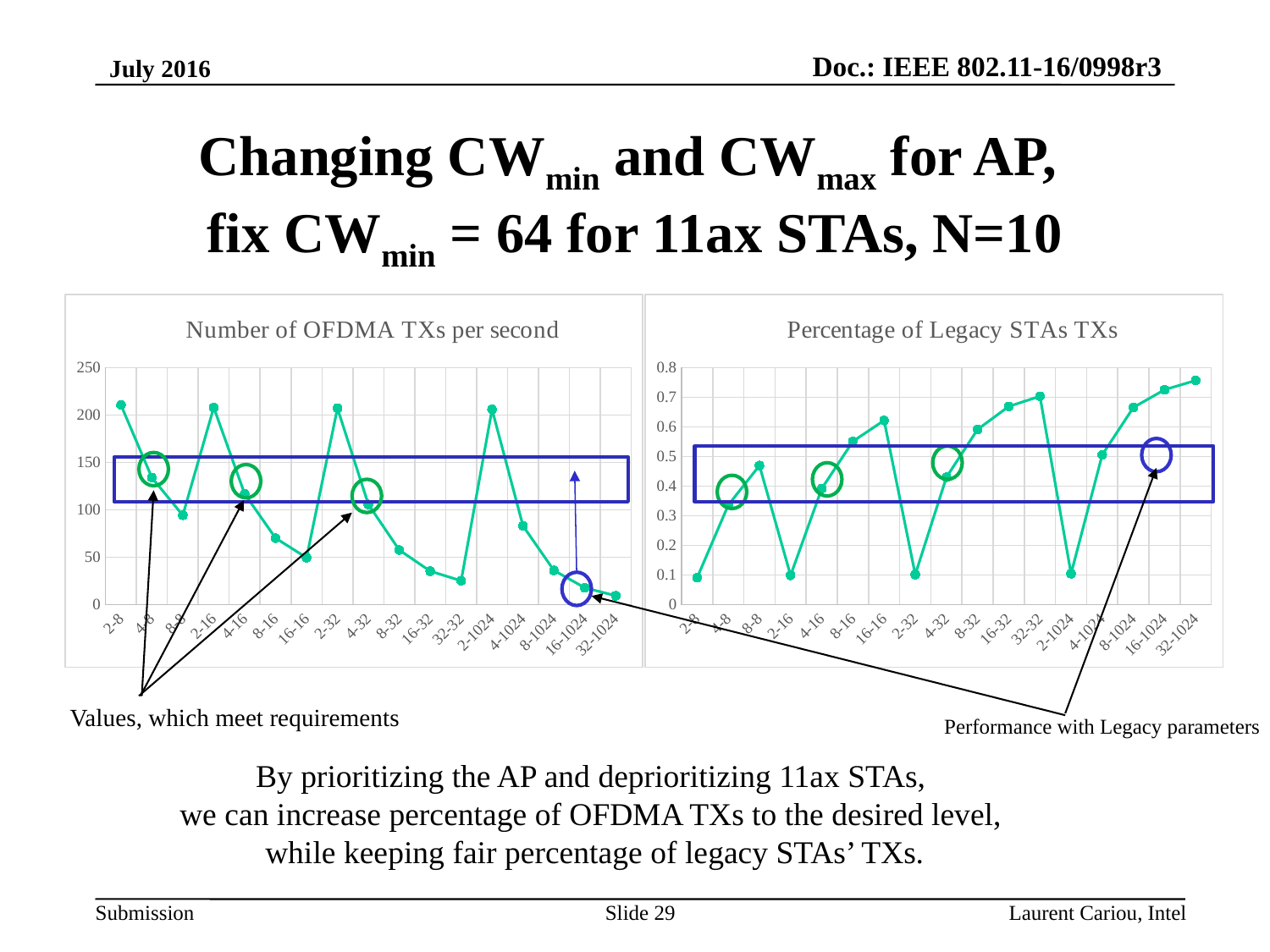
In the 'Number of OFDMA TXs per second' chart, how many categories are shown on the x axis? 17 What is the title of the chart on the right side of the slide? Percentage of Legacy STAs TXs What kind of chart is the 'Number of OFDMA TXs per second' chart on the left? line chart In the 'Percentage of Legacy STAs TXs' chart, is the value for 16-32 greater or less than 0.6? greater In the 'Number of OFDMA TXs per second' chart, which is larger, the value for 4-32 or the value for 8-32? 4-32 In the 'Percentage of Legacy STAs TXs' chart, which is larger, the value for 32-1024 or the value for 2-1024? 32-1024 In the 'Number of OFDMA TXs per second' chart, which is larger, the value for 2-8 or the value for 8-8? 2-8 In the 'Number of OFDMA TXs per second' chart, is the value for 2-8 greater or less than 200? greater In the 'Percentage of Legacy STAs TXs' chart, is the value for 32-1024 greater or less than 0.7? greater In the 'Percentage of Legacy STAs TXs' chart, how many categories are shown on the x axis? 17